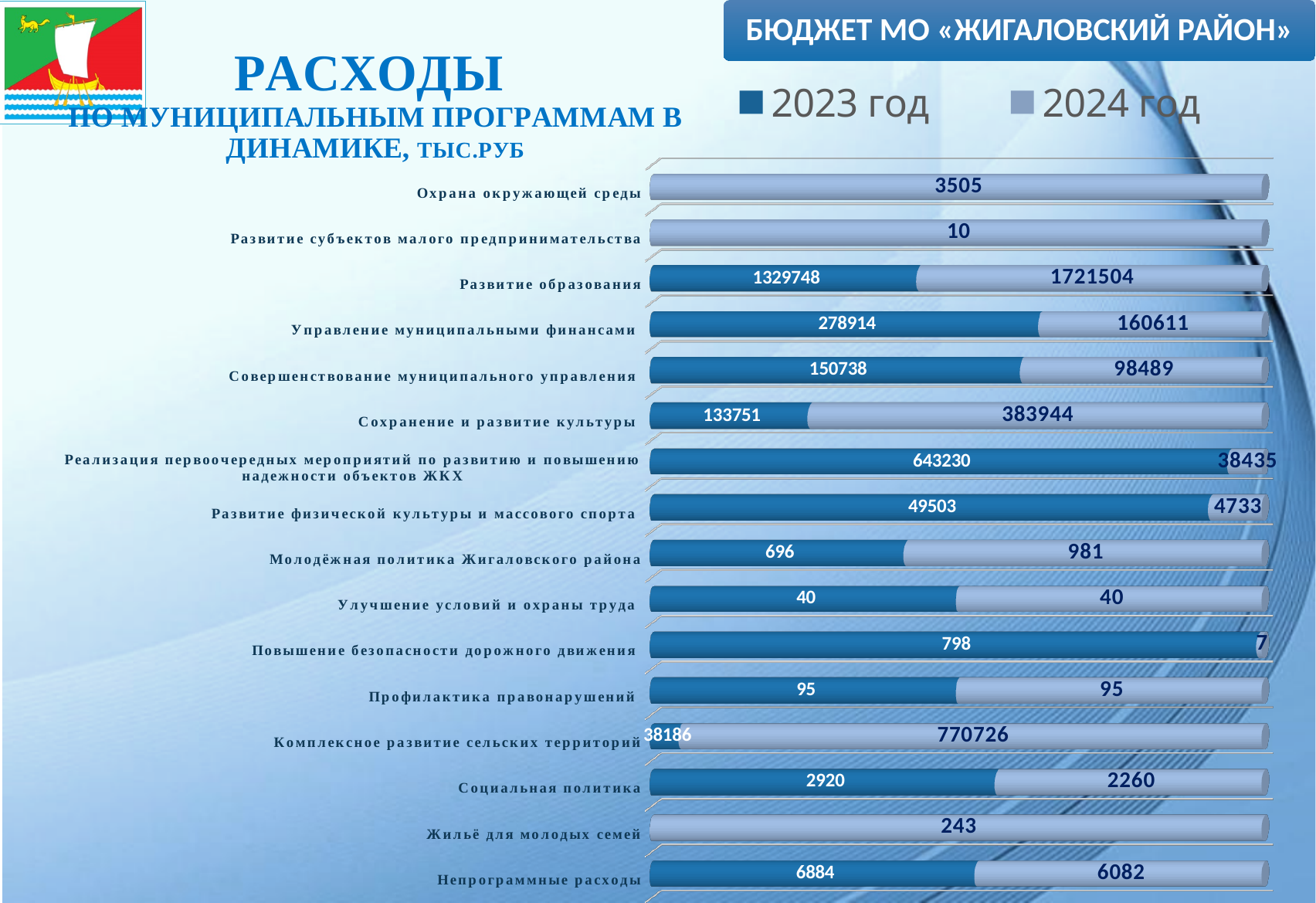
What is the difference between the 2024 год and 2023 год values for Развитие образования? 391756 What is the 2023 год value for Повышение безопасности дорожного движения? 798 For Молодёжная политика Жигаловского района, which year has the larger value, 2023 год or 2024 год? 2024 год What is the 2023 год value for Развитие образования? 1329748 Which category has the highest 2024 год value? Развитие образования What is the 2024 год value for Комплексное развитие сельских территорий? 770726 What is the difference between the 2023 год and 2024 год values for Непрограммные расходы? 802 What kind of chart is shown on the slide? Bar chart For Управление муниципальными финансами, which year has the larger value, 2023 год or 2024 год? 2023 год What is the 2024 год value for Сохранение и развитие культуры? 383944 How many categories are shown on the chart? 16 How many series does the legend list? 2